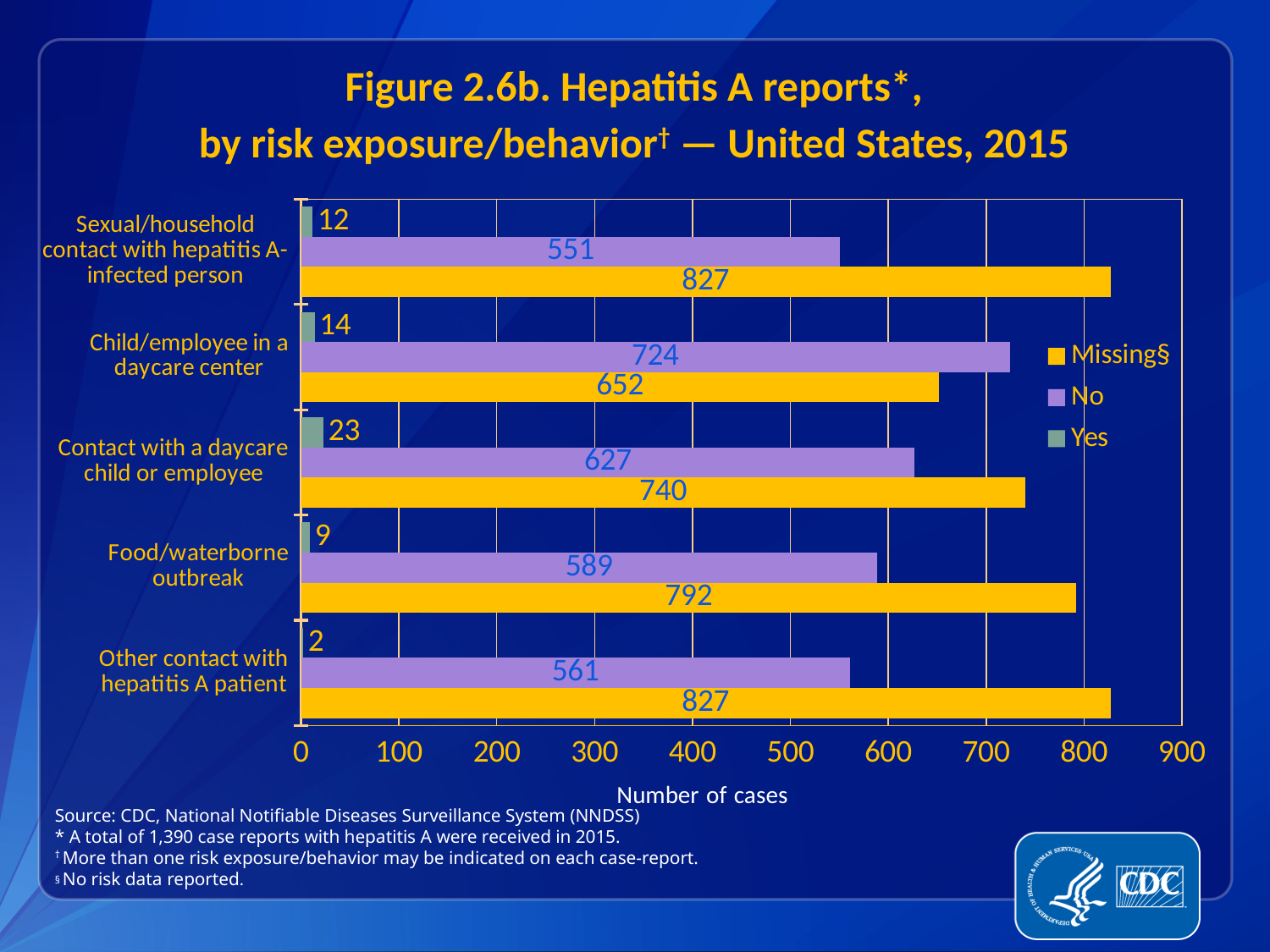
For Child/employee in a daycare center, which is larger: the "No" value or the "Missing" value? No How many risk exposure/behavior categories are plotted? 5 What is the number of cases in the "Missing" series for Food/waterborne outbreak? 792 Which category has the lowest value in the "Missing" series? Child/employee in a daycare center What is the number of cases in the "No" series for Child/employee in a daycare center? 724 What is the label of the x axis? Number of cases What is the number of cases in the "Yes" series for Contact with a daycare child or employee? 23 Which category has the highest value in the "Yes" series? Contact with a daycare child or employee How many series does the legend list? 3 What is the difference between the "No" values for Child/employee in a daycare center and Sexual/household contact with hepatitis A-infected person? 173 What type of chart is shown on the slide? Bar chart Which category has the lowest value in the "Yes" series? Other contact with hepatitis A patient